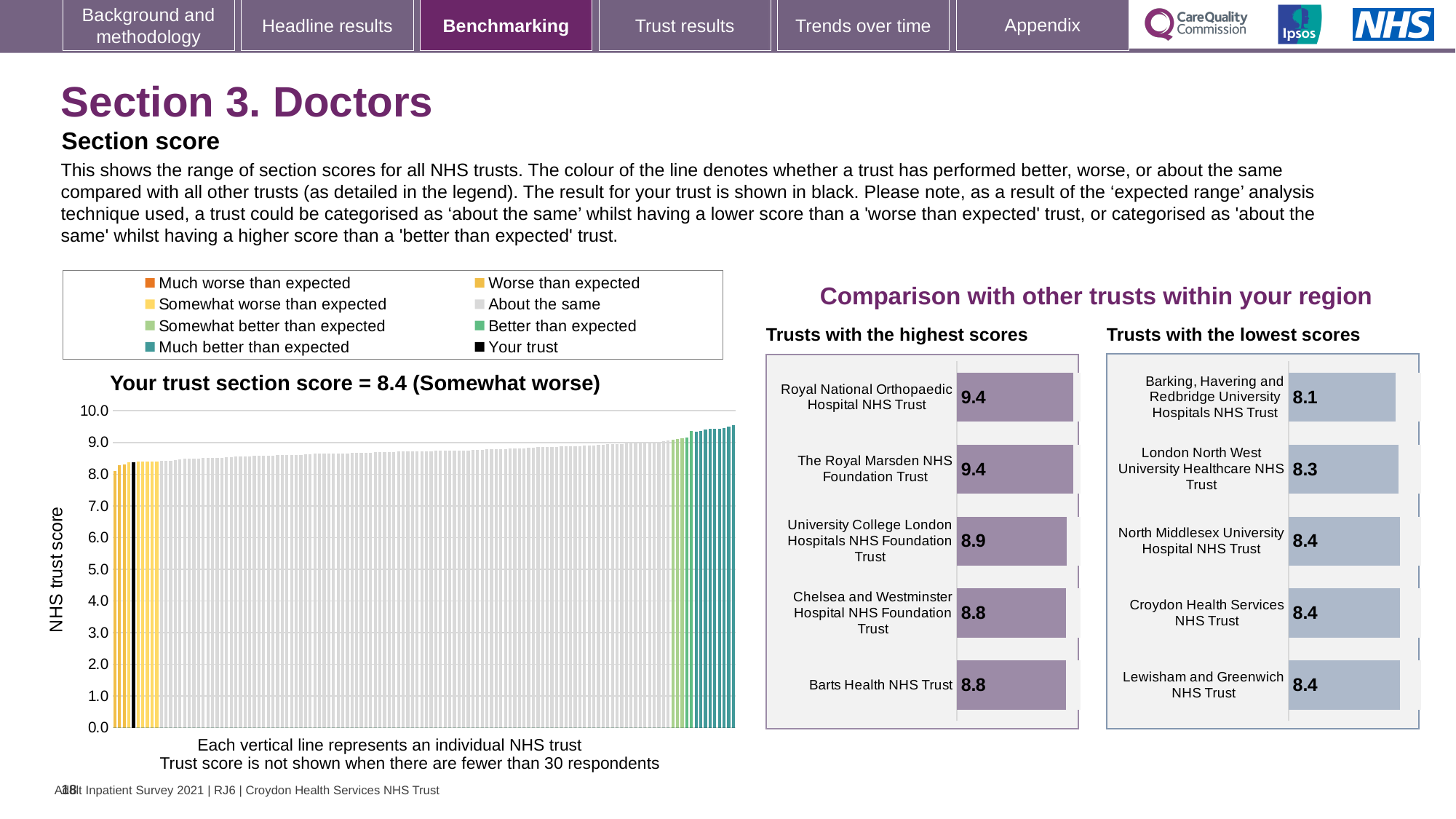
In the 'Trusts with the lowest scores' chart, which has the larger score: Barking, Havering and Redbridge University Hospitals NHS Trust or Croydon Health Services NHS Trust? Croydon Health Services NHS Trust In the 'Trusts with the lowest scores' chart, what is the score for London North West University Healthcare NHS Trust? 8.3 In the 'Your trust section score' chart, is the value of the tallest bar greater or less than 9.0? greater In the 'Trusts with the highest scores' chart, what is the difference between the scores of Royal National Orthopaedic Hospital NHS Trust and Barts Health NHS Trust? 0.6 In the 'Your trust section score' chart, do the bars rise or fall from left to right? rise In the 'Trusts with the highest scores' chart, how many trusts are shown? 5 In the 'Trusts with the lowest scores' chart, which trust has the lowest score? Barking, Havering and Redbridge University Hospitals NHS Trust In the 'Your trust section score' chart, what is the section score for your trust? 8.4 What is the y-axis label of the 'Your trust section score' chart? NHS trust score What kind of chart is the 'Your trust section score' chart? bar chart How many entries does the legend above the 'Your trust section score' chart list? 8 In the 'Trusts with the highest scores' chart, what is the score for University College London Hospitals NHS Foundation Trust? 8.9